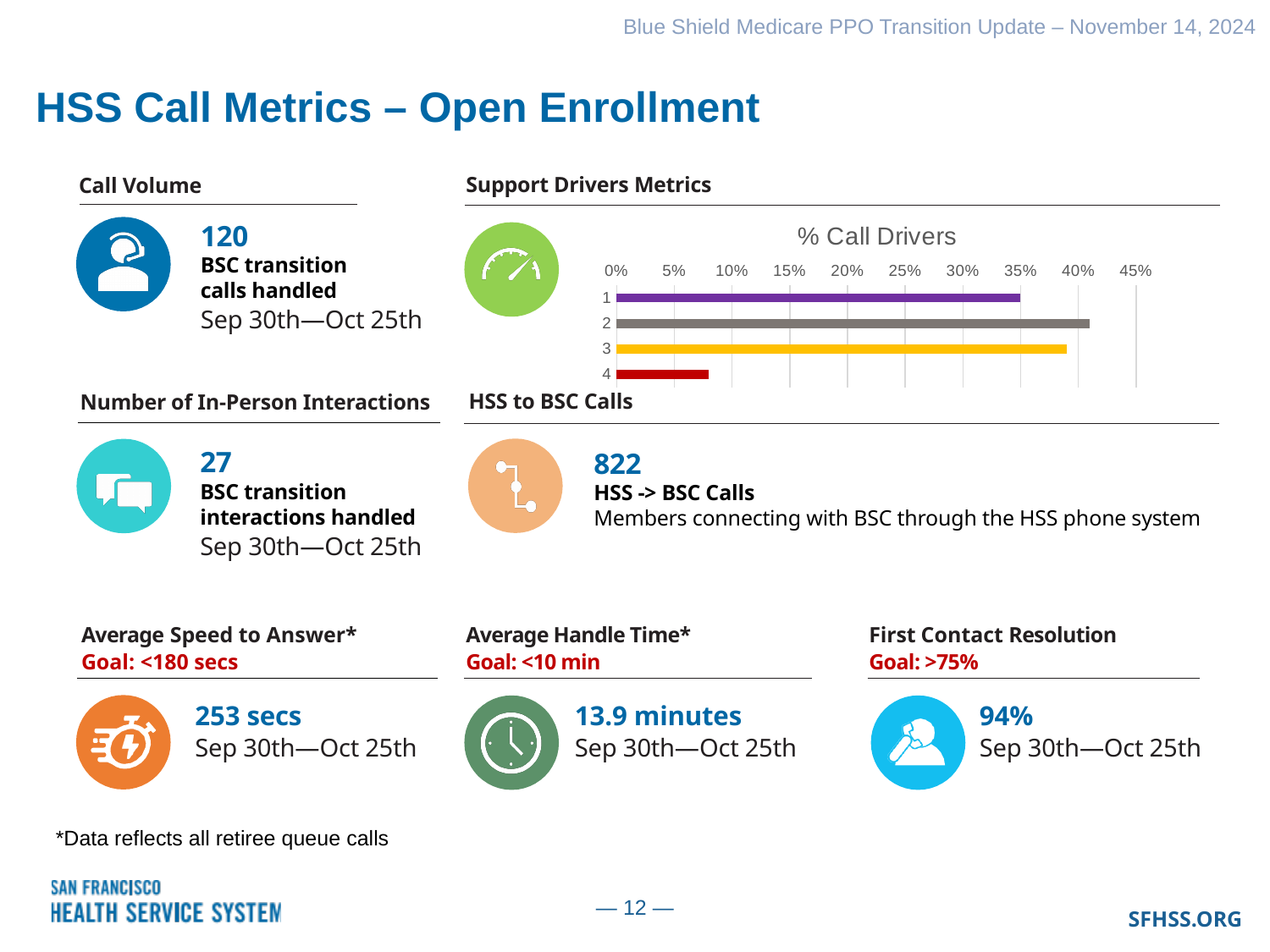
In the "% Call Drivers" chart, which is larger, the value for category 2 or category 4? 2 In the "% Call Drivers" chart, which is larger, the value for category 3 or category 1? 3 What is the highest value shown on the x axis of the "% Call Drivers" chart? 45% In the "% Call Drivers" chart, which category has the lowest value? 4 In the "% Call Drivers" chart, is the value for category 3 greater or less than 35%? greater In the "% Call Drivers" chart, is the value for category 2 greater or less than 40%? greater How many categories are plotted in the "% Call Drivers" chart? 4 In the "% Call Drivers" chart, which is larger, the value for category 1 or category 4? 1 What kind of chart is the "% Call Drivers" chart? bar chart What is the title of the chart on the slide? % Call Drivers In the "% Call Drivers" chart, is the value for category 4 greater or less than 10%? less